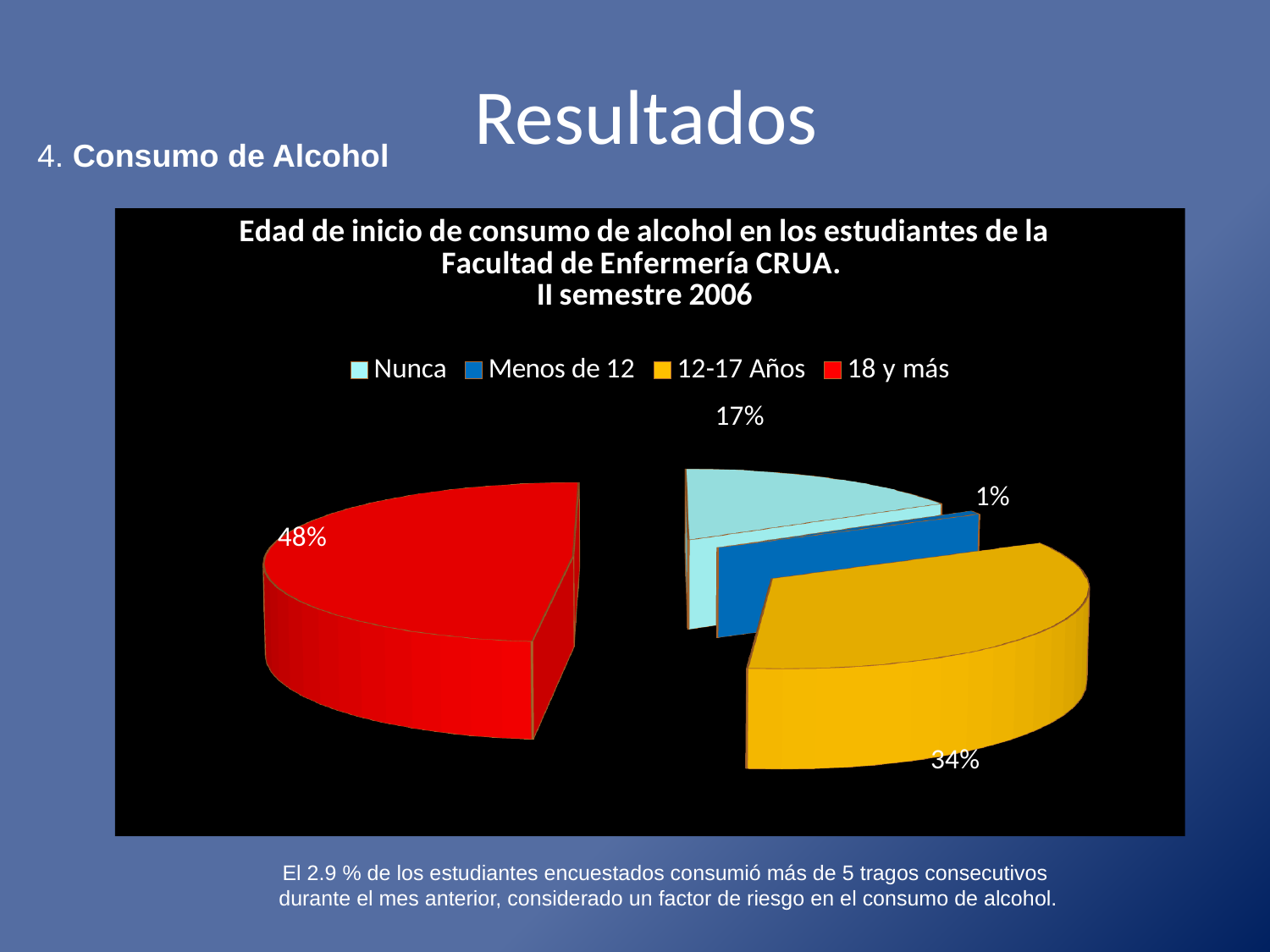
Which semester and year does the chart title refer to? II semestre 2006 What percentage of students is shown for the "18 y más" category? 48% What type of chart is shown on the slide? Pie chart Which is larger, the share for "Nunca" or the share for "12-17 Años"? 12-17 Años Which category has the smallest share of the pie? Menos de 12 How many categories does the legend list? 4 What percentage is shown for the "12-17 Años" category? 34% What is the difference in percentage points between "18 y más" and "12-17 Años"? 14 What percentage is shown for the "Menos de 12" category? 1% What percentage is shown for the "Nunca" category? 17% Which category has the largest share of the pie? 18 y más What colour is the slice for "18 y más"? Red